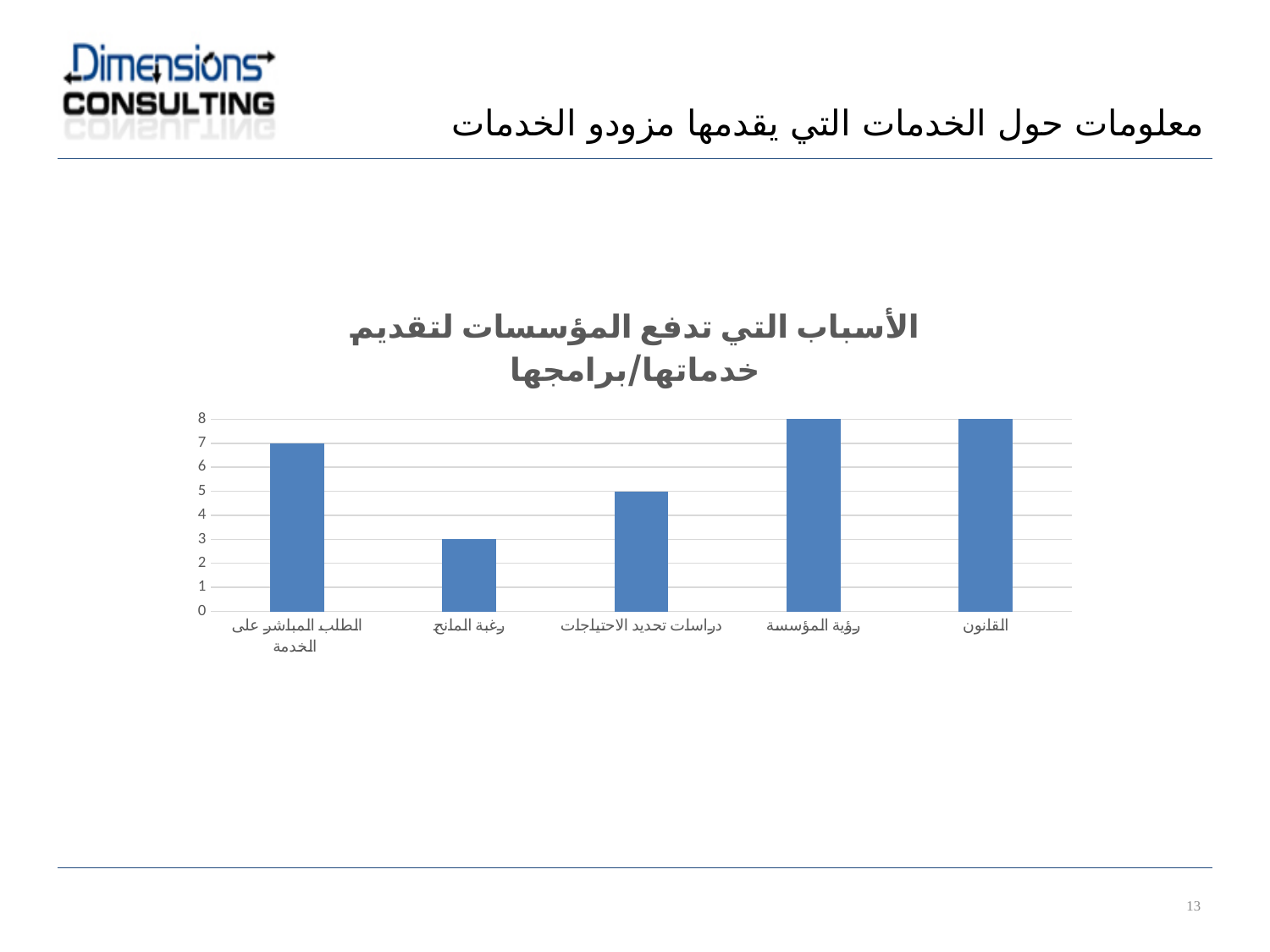
What is the difference between the values for الطلب المباشر على الخدمة and رغبة المانح? 4 What is the title of the chart? الأسباب التي تدفع المؤسسات لتقديم خدماتها/برامجها Is the value for الطلب المباشر على الخدمة greater or less than 5? greater How many categories are shown in the chart? 5 Which is larger, the value for دراسات تحديد الاحتياجات or the value for رغبة المانح? دراسات تحديد الاحتياجات Which category has the lowest value? رغبة المانح What is the value for رغبة المانح? 3 What is the value for دراسات تحديد الاحتياجات? 5 What is the value for الطلب المباشر على الخدمة? 7 What type of chart is shown on the slide? bar chart What is the difference between the values for رؤية المؤسسة and دراسات تحديد الاحتياجات? 3 What is the value for القانون? 8